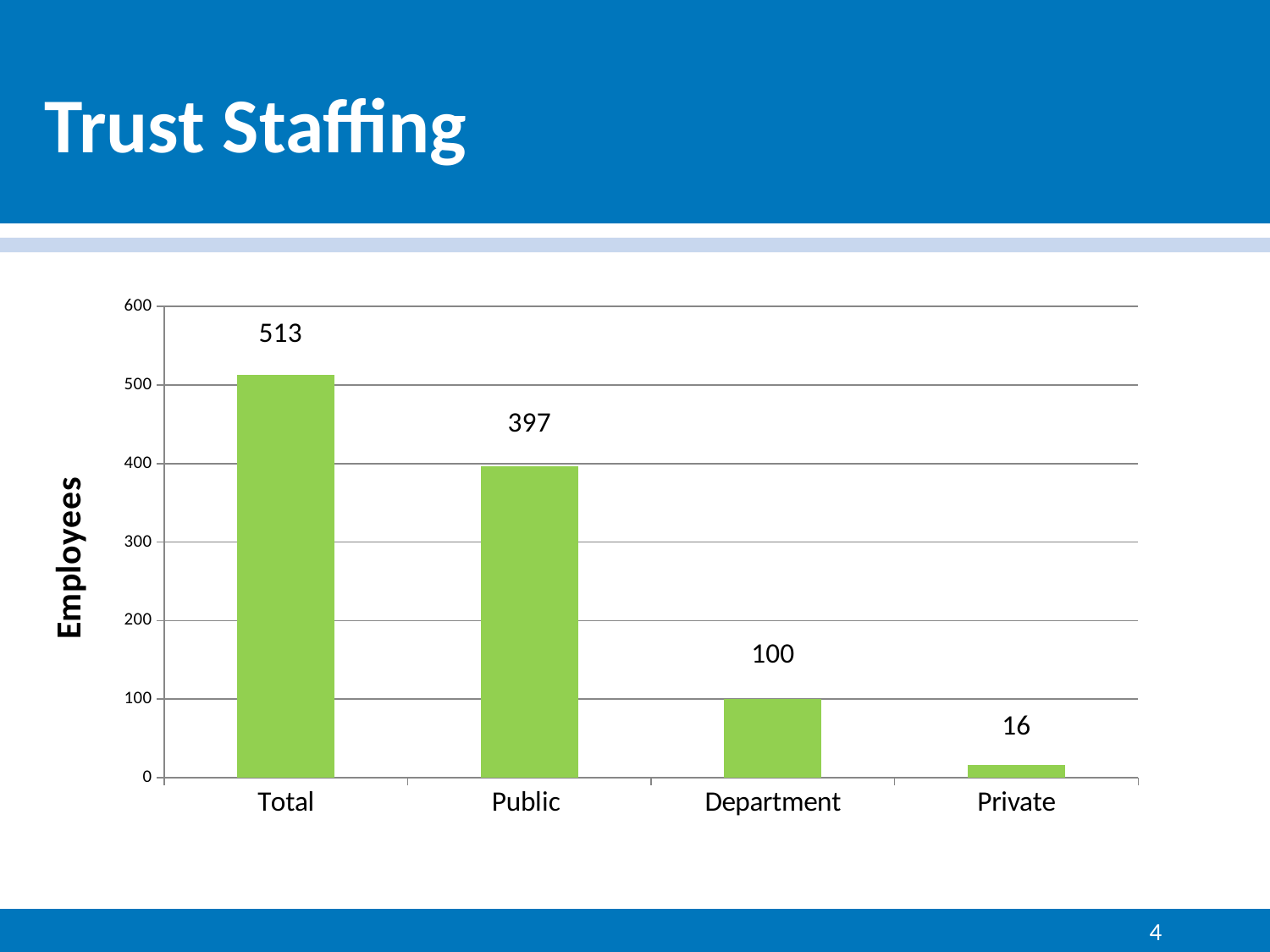
Which category has the highest value? Total What kind of chart is shown on the slide? Bar chart How many categories are shown on the x axis? 4 What is the label of the vertical axis? Employees What is the value for Private? 16 What is the difference between the values for Public and Department? 297 Which category has the lowest value? Private Which is larger, the value for Department or the value for Private? Department What is the difference between the values for Total and Public? 116 What is the value for Public? 397 What is the value for Department? 100 What is the value for Total? 513